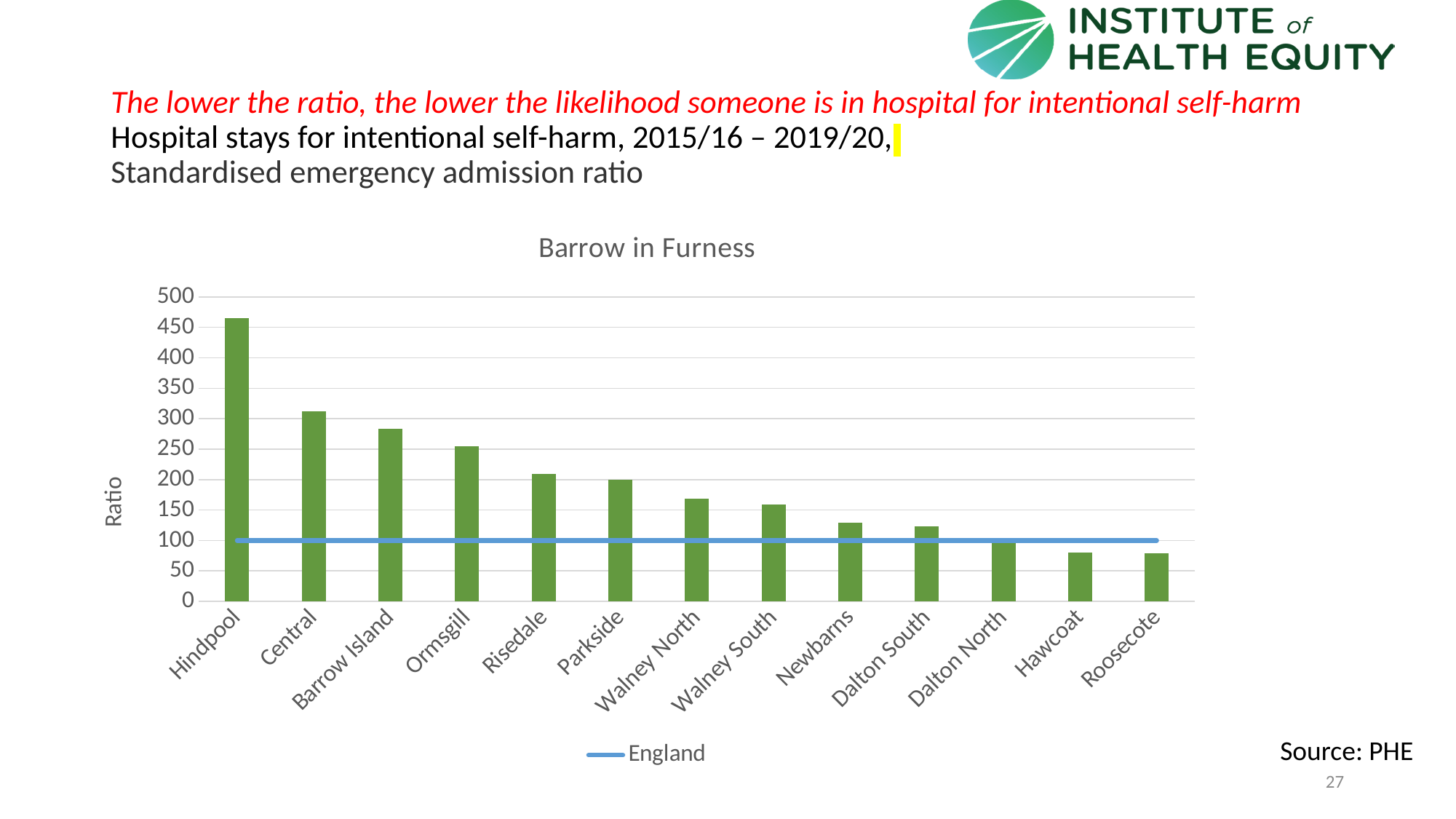
What is the title of the chart? Barrow in Furness Is the value for Newbarns greater or less than 100? greater What kind of chart is shown on the slide? Combination bar and line chart (bars with a horizontal line for England) Is the value for Barrow Island greater or less than 300? less Is the value for Hawcoat greater or less than 100? less Do the bar values rise or fall moving from left to right along the x axis? Fall Which has the larger ratio, Central or Barrow Island? Central How many wards (categories) are plotted on the x axis? 13 Which ward has the highest ratio? Hindpool What does the horizontal blue line in the chart represent, according to the legend? England